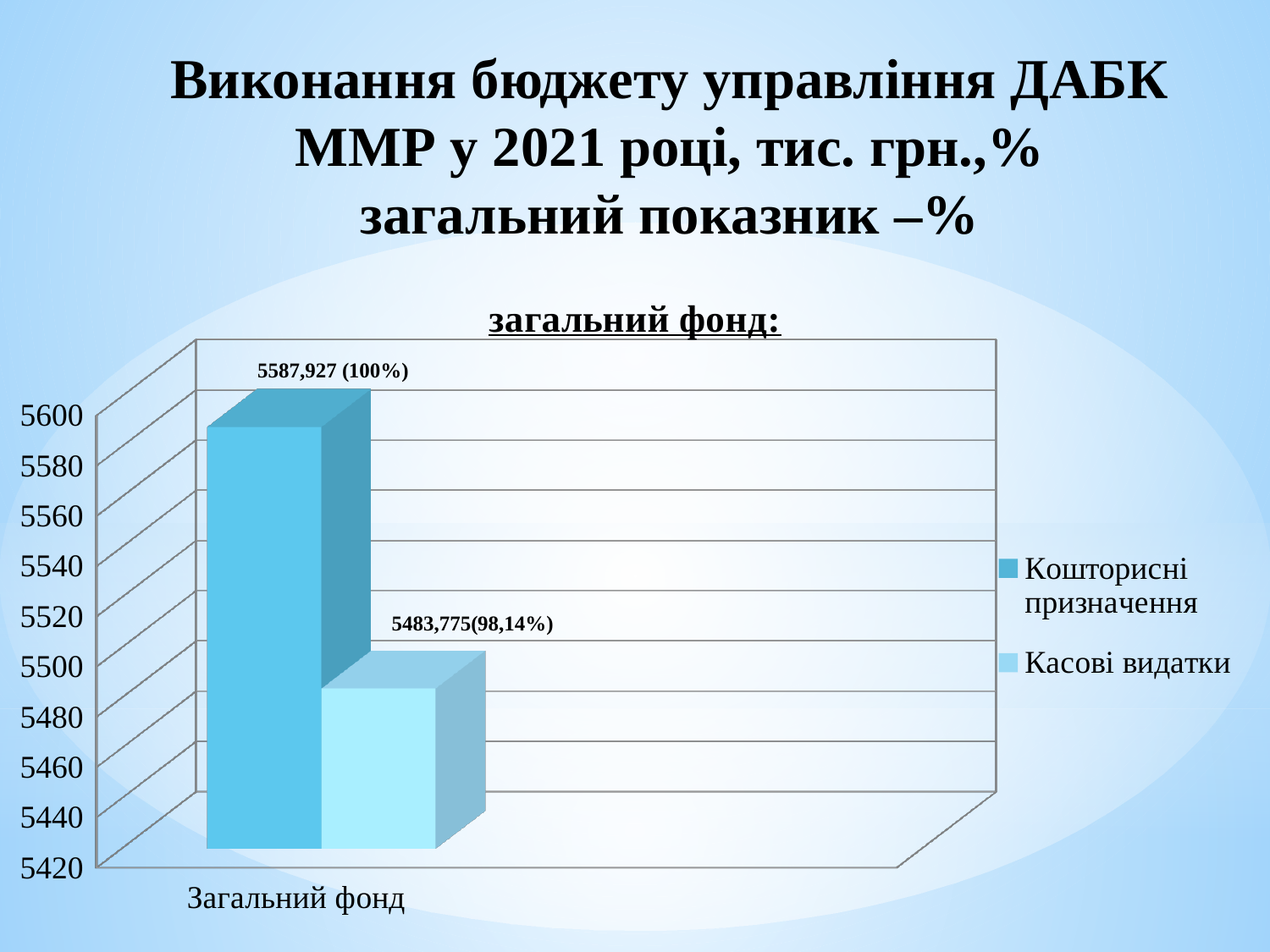
What is the title of the chart? загальний фонд: What is the difference between the Кошторисні призначення value and the Касові видатки value (in тис. грн.)? 104,152 What is the value shown for Касові видатки in the chart? 5483,775(98,14%) Is the value for Касові видатки greater or less than 5500? less What percentage is shown next to the Касові видатки bar? 98,14% How many series does the legend list? 2 How many categories are shown on the x axis? 1 Is the value for Кошторисні призначення greater or less than 5580? greater What kind of chart is shown on the slide? Bar chart What is the value shown for Кошторисні призначення in the chart? 5587,927 (100%) Which series has the lowest value in the chart? Касові видатки Which series has the higher value, Кошторисні призначення or Касові видатки? Кошторисні призначення